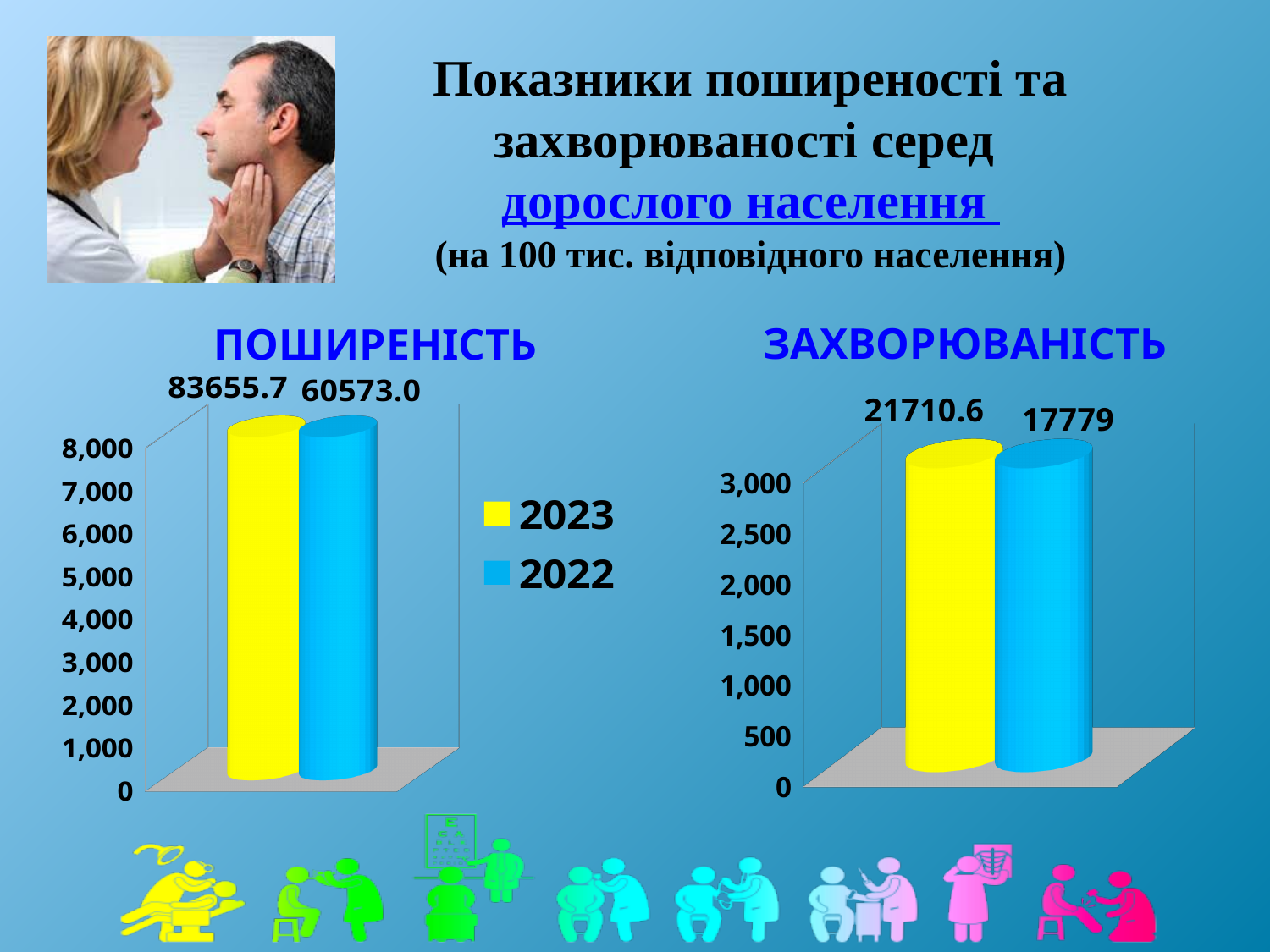
In the ЗАХВОРЮВАНІСТЬ chart, is the value for 2023 larger or smaller than the value for 2022? larger In the legend, which colour represents 2022? blue How many series does the legend list? 2 In the ПОШИРЕНІСТЬ chart, what is the value for 2023? 83655.7 In the ЗАХВОРЮВАНІСТЬ chart, what is the value for 2023? 21710.6 In the ПОШИРЕНІСТЬ chart, what is the difference between the 2023 and 2022 values? 23082.7 In the ПОШИРЕНІСТЬ chart, what is the value for 2022? 60573.0 In the ПОШИРЕНІСТЬ chart, which year has the higher value? 2023 What kind of chart is the ПОШИРЕНІСТЬ chart? bar chart In the ЗАХВОРЮВАНІСТЬ chart, what is the difference between the 2023 and 2022 values? 3931.6 In the ЗАХВОРЮВАНІСТЬ chart, what is the value for 2022? 17779 In the ЗАХВОРЮВАНІСТЬ chart, which year has the lower value? 2022